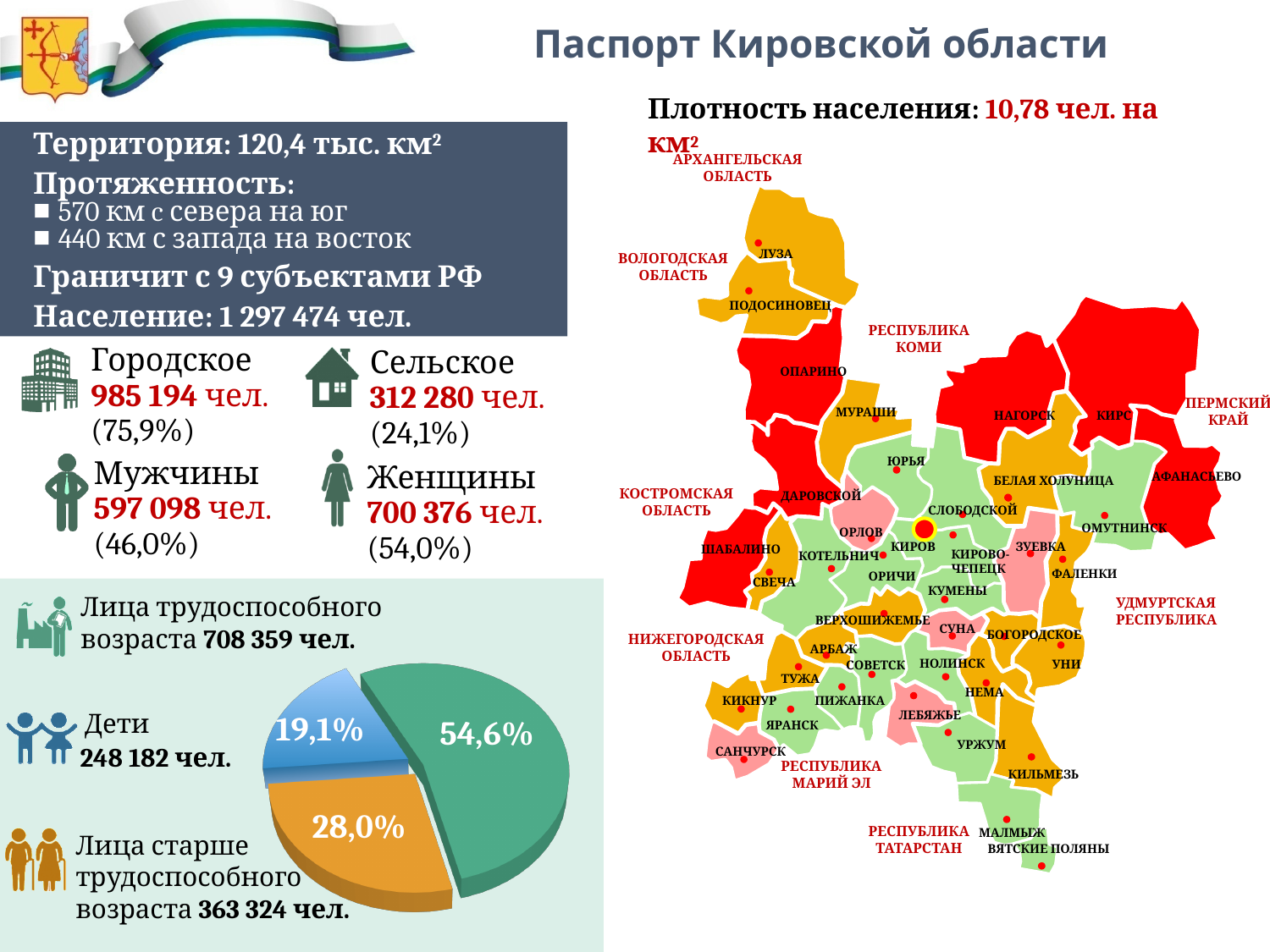
What kind of chart is shown on the slide? pie chart Is the share of the green slice in the pie chart greater or less than 50%? greater What is the difference in percentage points between the green slice (54,6%) and the orange slice (28,0%) of the pie chart? 26,6 What is the difference in percentage points between the orange slice (28,0%) and the blue slice (19,1%) of the pie chart? 8,9 What colour is the largest slice of the pie chart? green How many slices does the pie chart have? 3 What share is shown on the orange slice of the pie chart? 28,0% What is the smallest share shown in the pie chart? 19,1% Which is larger in the pie chart, the orange slice or the blue slice? the orange slice What is the largest share shown in the pie chart? 54,6% What share is shown on the green slice of the pie chart? 54,6% What share is shown on the blue slice of the pie chart? 19,1%